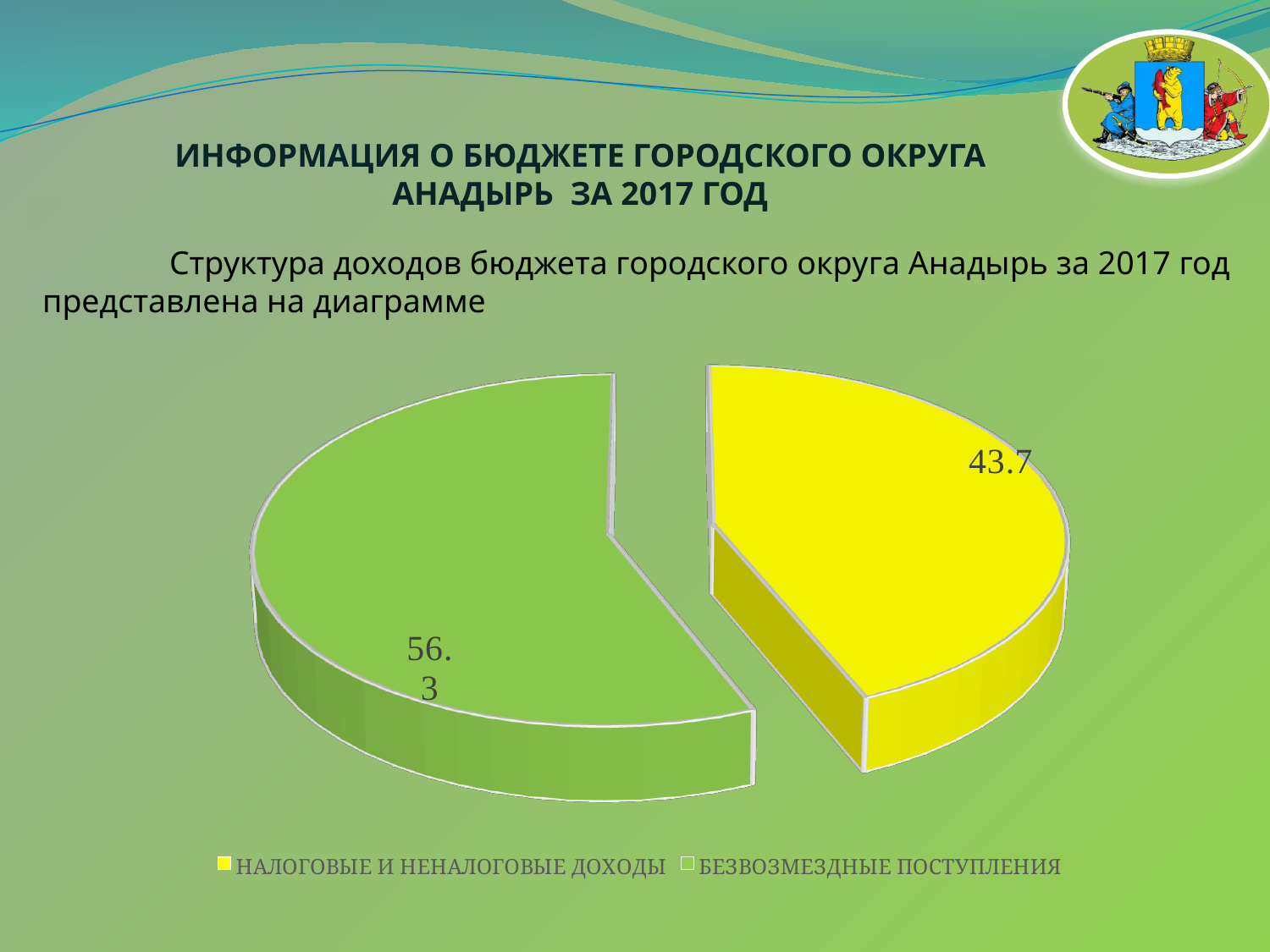
Which category has the largest slice of the pie? БЕЗВОЗМЕЗДНЫЕ ПОСТУПЛЕНИЯ What is the total of the two values shown on the pie chart? 100 What kind of chart is shown on the slide? Pie chart What colour is the slice for БЕЗВОЗМЕЗДНЫЕ ПОСТУПЛЕНИЯ? Green What value is shown for the НАЛОГОВЫЕ И НЕНАЛОГОВЫЕ ДОХОДЫ slice? 43.7 Which is larger: НАЛОГОВЫЕ И НЕНАЛОГОВЫЕ ДОХОДЫ or БЕЗВОЗМЕЗДНЫЕ ПОСТУПЛЕНИЯ? БЕЗВОЗМЕЗДНЫЕ ПОСТУПЛЕНИЯ What value is shown for the БЕЗВОЗМЕЗДНЫЕ ПОСТУПЛЕНИЯ slice? 56.3 How many entries does the legend list? 2 How many slices does the pie chart have? 2 What colour is the slice for НАЛОГОВЫЕ И НЕНАЛОГОВЫЕ ДОХОДЫ? Yellow What is the difference between the values for БЕЗВОЗМЕЗДНЫЕ ПОСТУПЛЕНИЯ and НАЛОГОВЫЕ И НЕНАЛОГОВЫЕ ДОХОДЫ? 12.6 Which category has the smallest slice of the pie? НАЛОГОВЫЕ И НЕНАЛОГОВЫЕ ДОХОДЫ